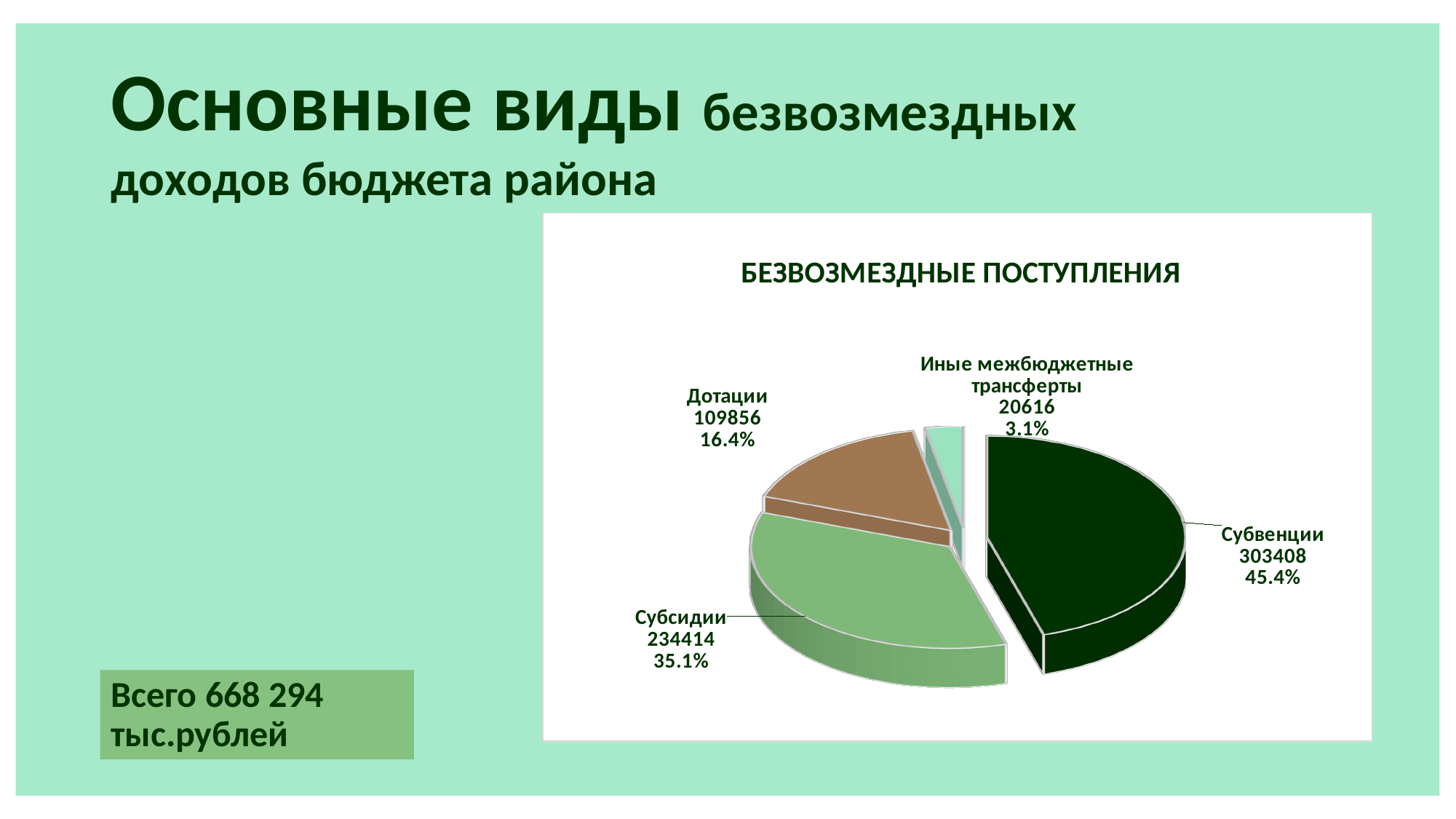
Which category has the smallest value? Иные межбюджетные трансферты What is the value for Дотации? 109856 What is the value for Субсидии? 234414 Which category has the largest value? Субвенции What share of the pie does Дотации represent? 16.4% What is the value for Иные межбюджетные трансферты? 20616 Which is larger, the value for Дотации or the value for Иные межбюджетные трансферты? Дотации What share of the pie does Субвенции represent? 45.4% What is the value for Субвенции? 303408 What is the difference between the values for Субвенции and Субсидии? 68994 How many categories are shown in the pie chart? 4 What type of chart is shown on the slide? Pie chart